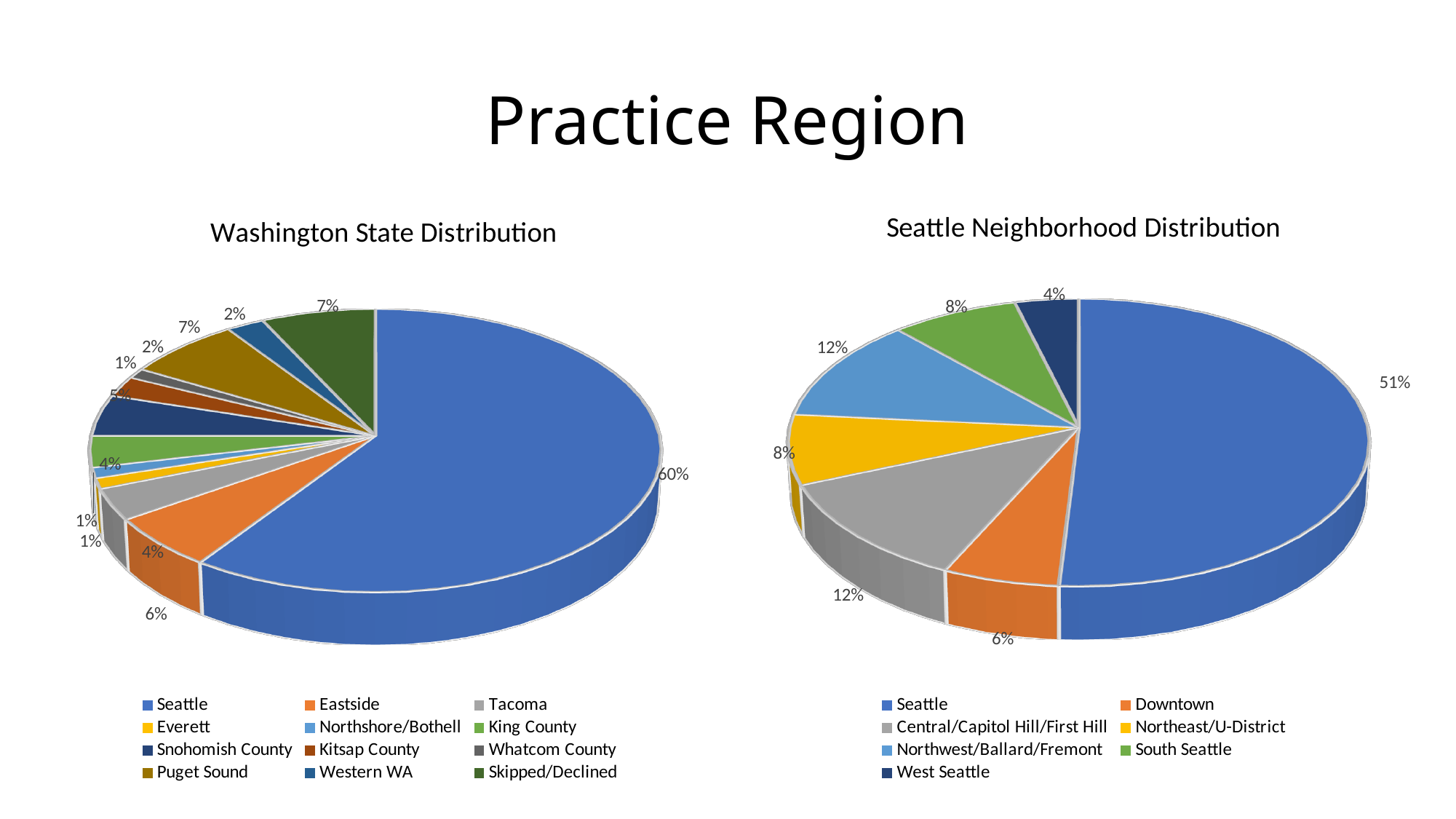
In the Washington State Distribution chart, which category has the largest share? Seattle In the Seattle Neighborhood Distribution chart, which is larger, Central/Capitol Hill/First Hill or South Seattle? Central/Capitol Hill/First Hill In the Washington State Distribution chart, what percentage is Eastside? 6% What kind of chart is the Seattle Neighborhood Distribution chart? Pie chart In the Seattle Neighborhood Distribution chart, what percentage is Seattle? 51% In the Seattle Neighborhood Distribution chart, what percentage is West Seattle? 4% In the Washington State Distribution chart, what percentage is Snohomish County? 5% In the Washington State Distribution chart, what percentage is Seattle? 60% In the Seattle Neighborhood Distribution chart, which category has the smallest share? West Seattle In the Washington State Distribution chart, what is the difference between the Seattle share and the Eastside share? 54% In the Washington State Distribution chart, how many categories does the legend list? 12 In the Seattle Neighborhood Distribution chart, what percentage is Downtown? 6%